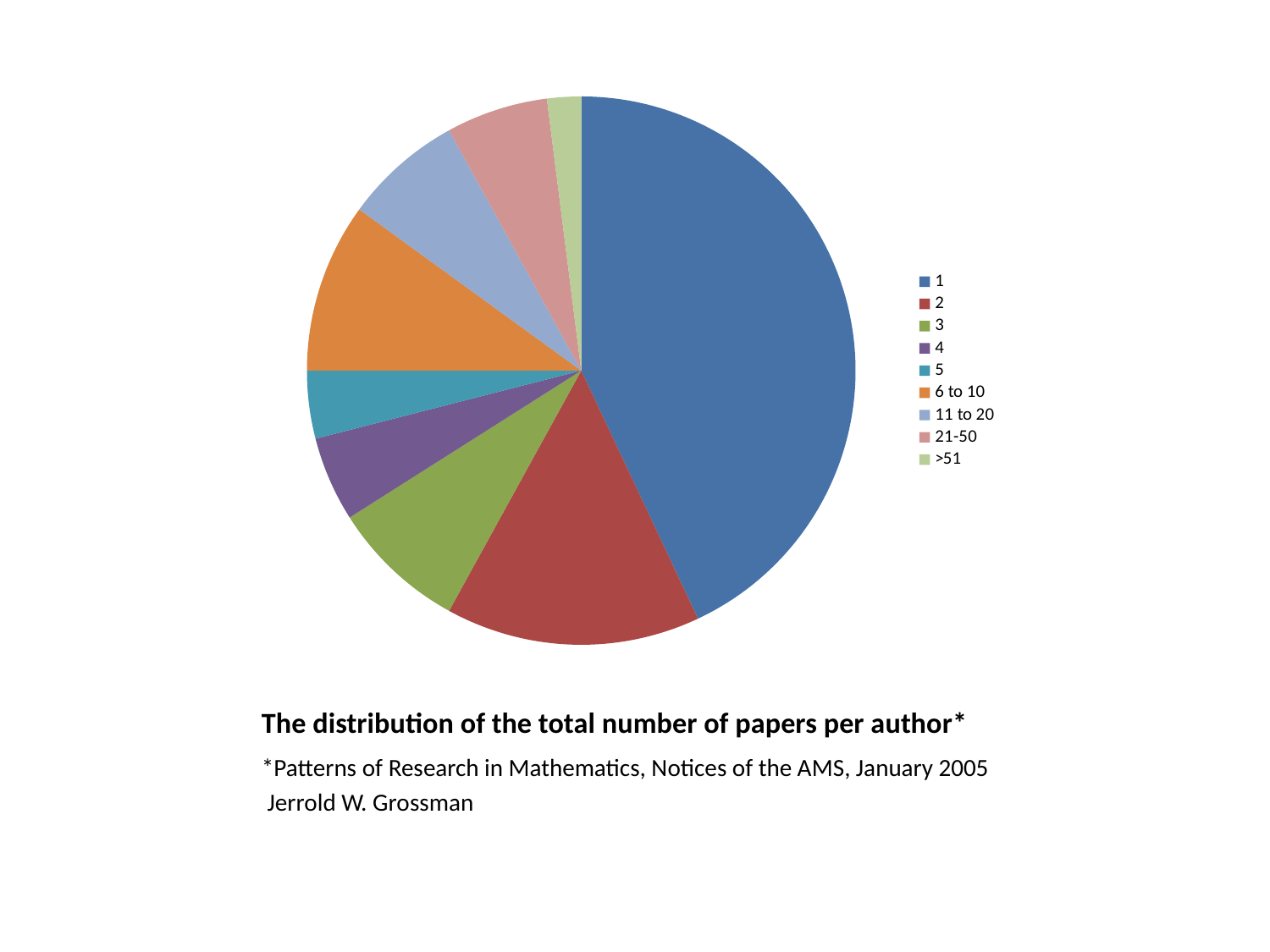
Which slice is larger, the one for 5 or the one for 6 to 10? 6 to 10 Which category has the largest slice of the pie? 1 Which slice is larger, the one for 2 or the one for 3? 2 Which slice is larger, the one for 21-50 or the one for >51? 21-50 Which category has the smallest slice of the pie? >51 What colour is the slice for category 1 in the pie chart? blue What kind of chart is shown on the slide? pie chart How many categories (slices) does the pie chart have? 9 What is the title of the chart on the slide? The distribution of the total number of papers per author*